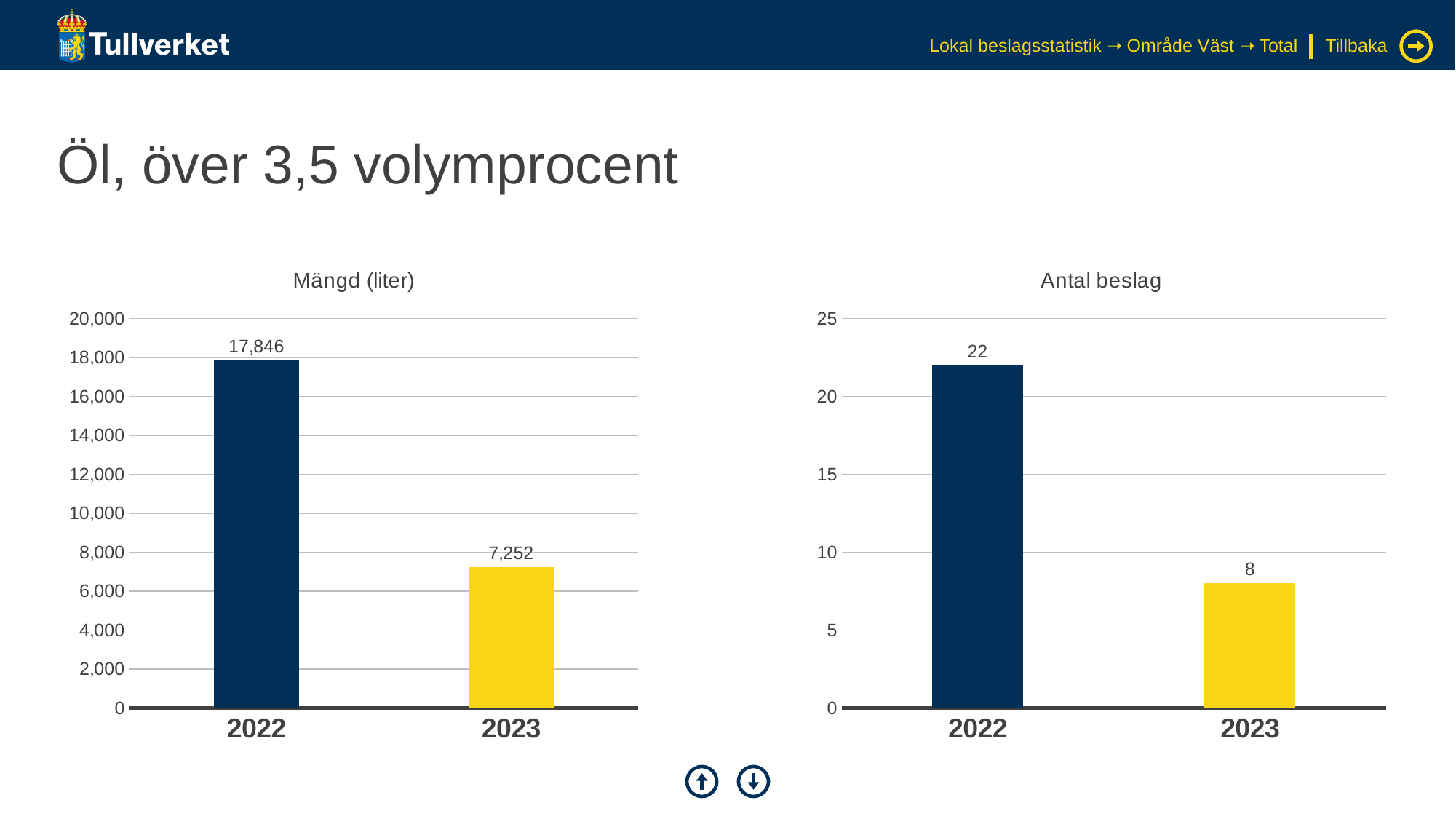
In the 'Antal beslag' chart, is the value for 2022 greater or less than 20? greater In the 'Mängd (liter)' chart, what is the difference between the 2022 and 2023 values? 10,594 In the 'Mängd (liter)' chart, what is the value for 2023? 7,252 In the 'Antal beslag' chart, what is the difference between the 2022 and 2023 values? 14 In the 'Mängd (liter)' chart, do the values rise or fall from 2022 to 2023? fall In the 'Antal beslag' chart, what is the value for 2022? 22 In the 'Antal beslag' chart, which year has the lowest value? 2023 In the 'Mängd (liter)' chart, which year has the highest value? 2022 In the 'Mängd (liter)' chart, what is the value for 2022? 17,846 In the 'Antal beslag' chart, what is the value for 2023? 8 How many years are shown in the 'Mängd (liter)' chart? 2 What kind of chart is the 'Antal beslag' chart? bar chart